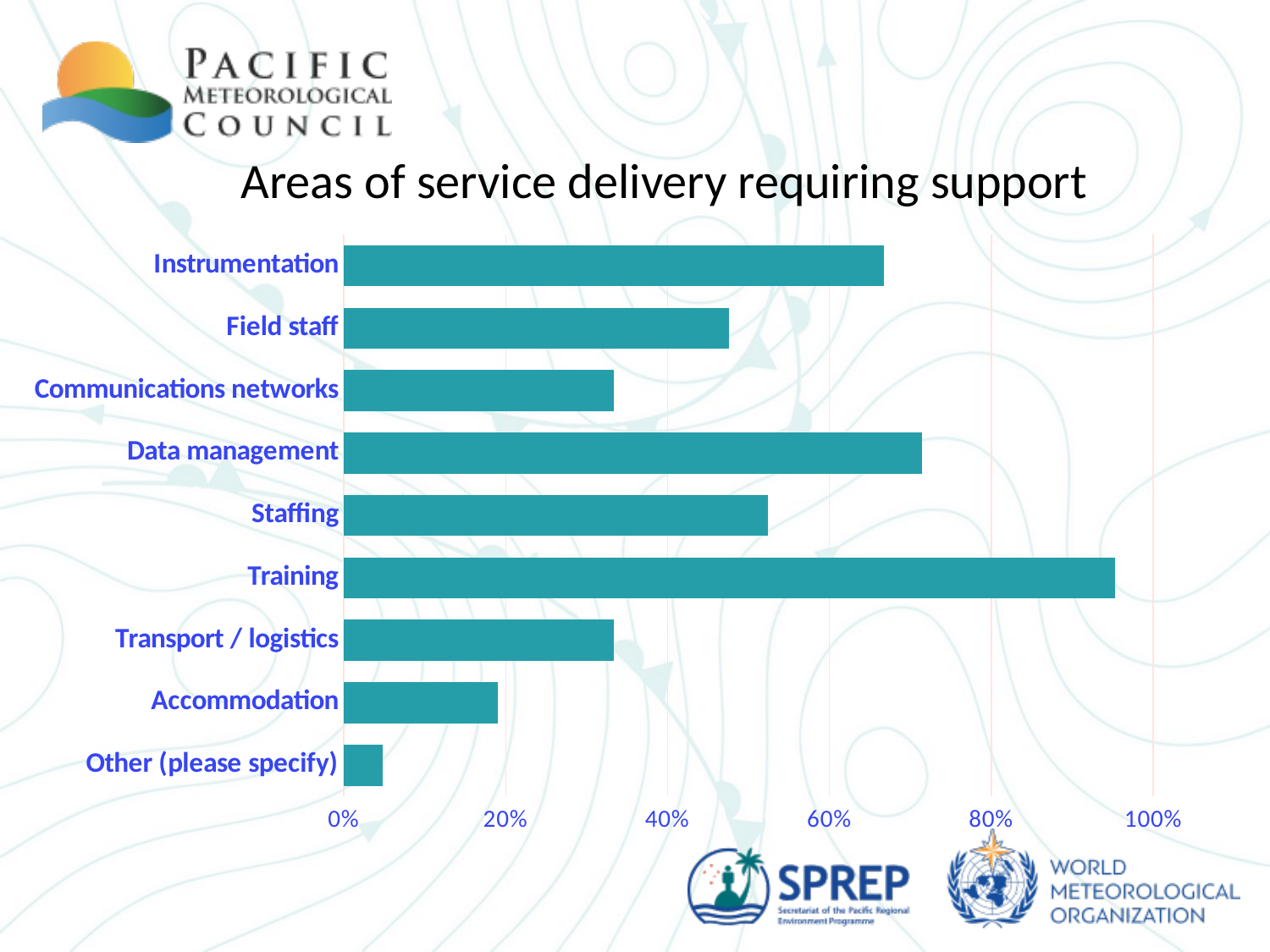
Is the value for Instrumentation greater or less than 60%? greater Which is larger, the value for Instrumentation or the value for Field staff? Instrumentation Is the value for Staffing greater or less than 40%? greater What kind of chart is shown on the slide? Bar chart What is the title of the chart? Areas of service delivery requiring support Which category has the highest value? Training Which category has the lowest value? Other (please specify) Is the value for Data management greater or less than 60%? greater Which is larger, the value for Transport / logistics or the value for Accommodation? Transport / logistics How many categories are plotted in the chart? 9